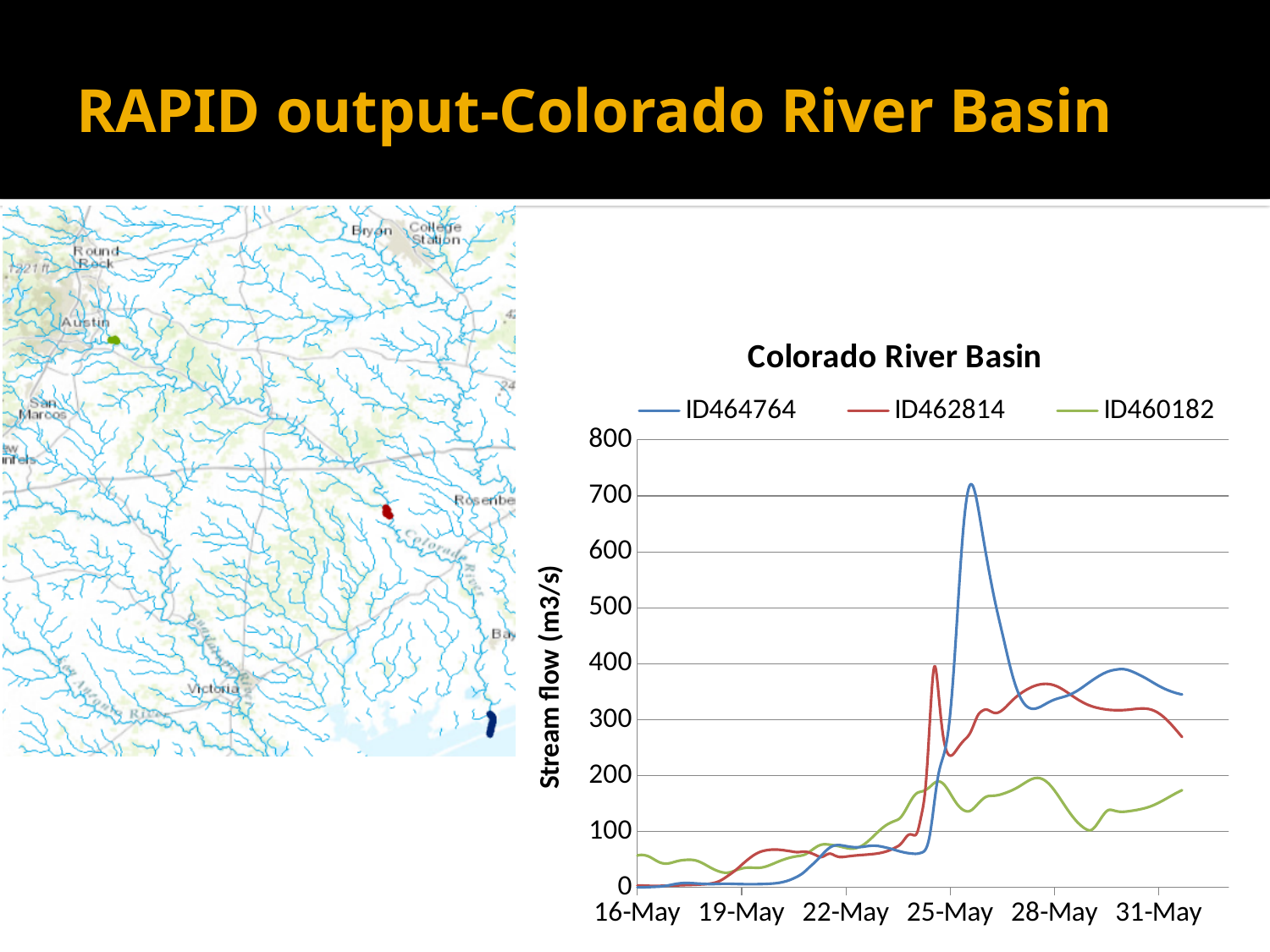
Is the value for ID464764 on 16-May greater or less than 100? less Which series has the lowest peak stream flow in the chart? ID460182 On 31-May, which series has the higher stream flow, ID464764 or ID460182? ID464764 Which series reaches the highest peak stream flow in the chart? ID464764 Is the peak value for ID464764 greater or less than 600? greater What kind of chart is shown on the slide? line chart How many series does the legend of the Colorado River Basin chart list? 3 Is the peak value for ID460182 greater or less than 100? greater What is the title of the chart on the slide? Colorado River Basin What is the label of the vertical axis of the chart? Stream flow (m3/s) Between 16-May and 25-May, does the stream flow for ID464764 generally rise or fall? rise